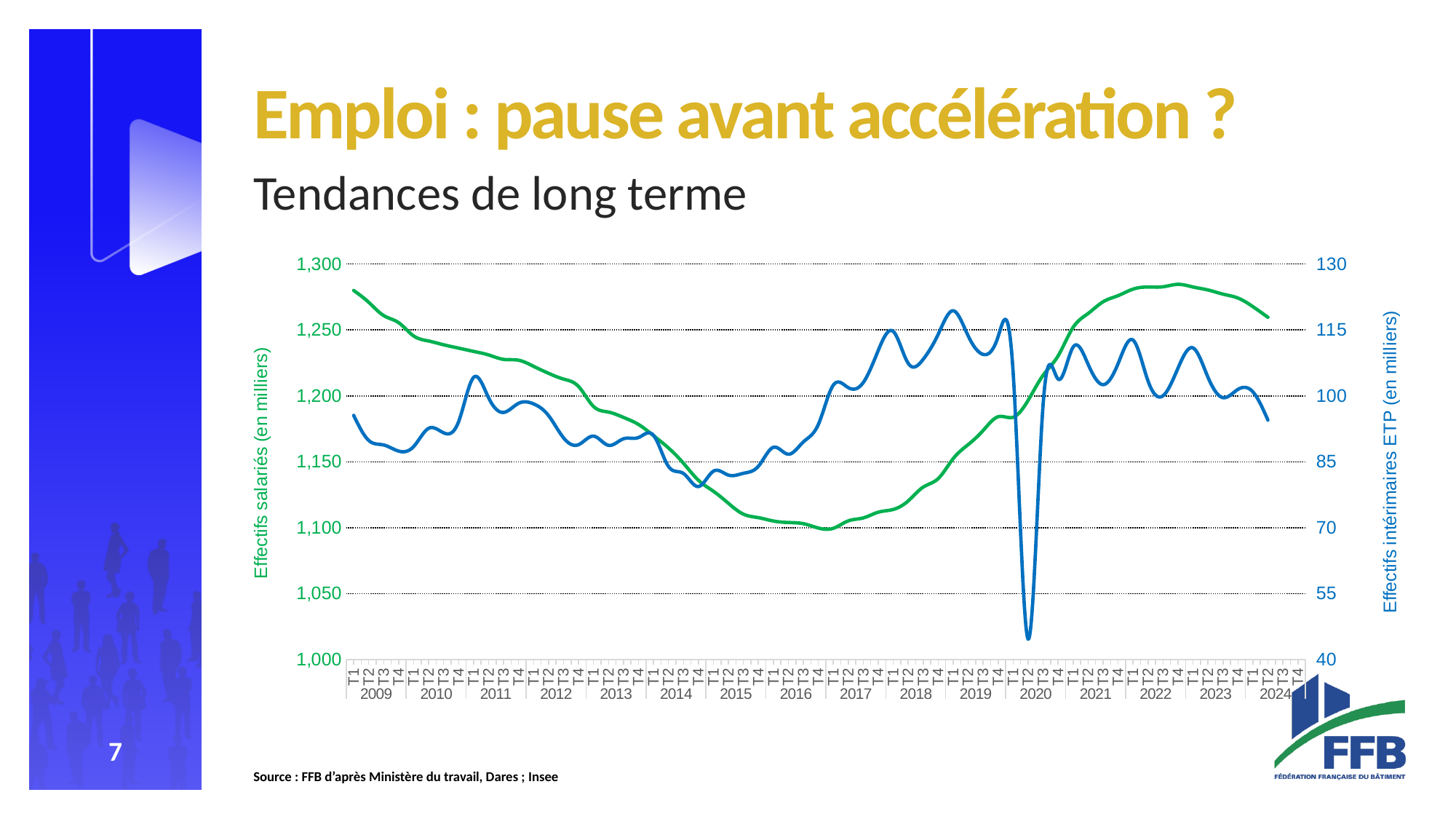
Does the green line (Effectifs salariés) rise or fall between 2017 and 2022? rise How many years are labelled along the x axis? 16 Does the green line (Effectifs salariés) rise or fall between 2009 and 2016? fall Is the value of the green line (Effectifs salariés) at T1 2009 greater or less than 1,250? greater What is the title of the right vertical axis? Effectifs intérimaires ETP (en milliers) In which quarter does the blue line (Effectifs intérimaires ETP) reach its lowest point? T2 2020 Is the value of the blue line (Effectifs intérimaires ETP) at T1 2019 greater or less than 100? greater What is the title of the left vertical axis? Effectifs salariés (en milliers) Is the value of the blue line (Effectifs intérimaires ETP) at T2 2020 greater or less than 55? less What kind of chart is shown on the slide? line chart Which is larger: the green line (Effectifs salariés) value at T1 2009 or at T1 2017? T1 2009